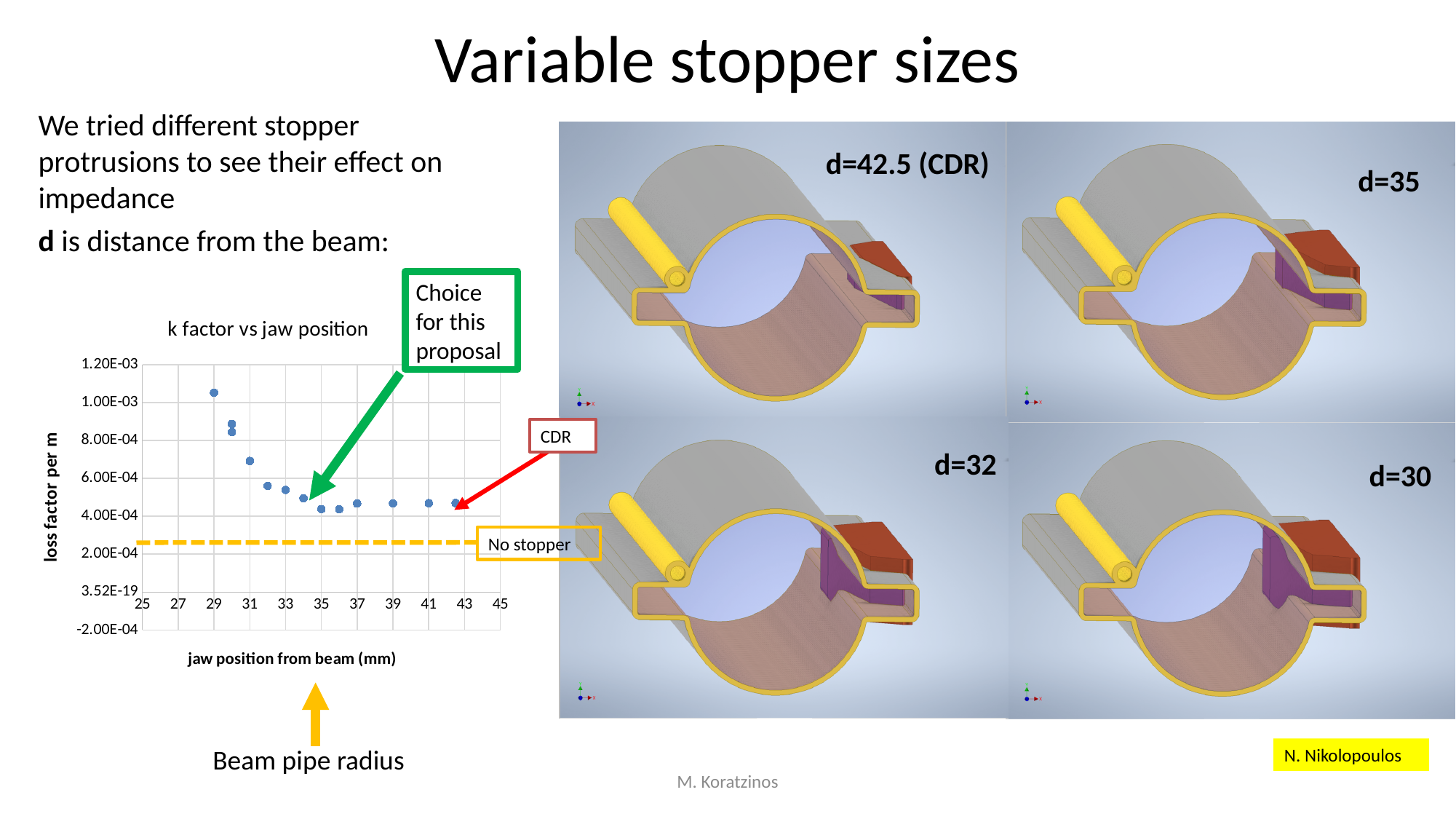
In the "k factor vs jaw position" chart, is the loss factor at jaw position 31 mm greater or less than 6.00E-04? greater In the "k factor vs jaw position" chart, is the loss factor at jaw position 35 mm greater or less than 6.00E-04? less In the "k factor vs jaw position" chart, which has the larger loss factor: jaw position 29 mm or jaw position 37 mm? 29 mm In the "k factor vs jaw position" chart, do the loss factor values rise or fall as the jaw position increases from 29 mm to 35 mm? fall What is the x-axis label of the "k factor vs jaw position" chart? jaw position from beam (mm) In the "k factor vs jaw position" chart, is the loss factor at jaw position 30 mm greater or less than 8.00E-04? greater What is the title of the chart on the slide? k factor vs jaw position What kind of chart is "k factor vs jaw position"? scatter chart In the "k factor vs jaw position" chart, at which jaw position is the loss factor highest? 29